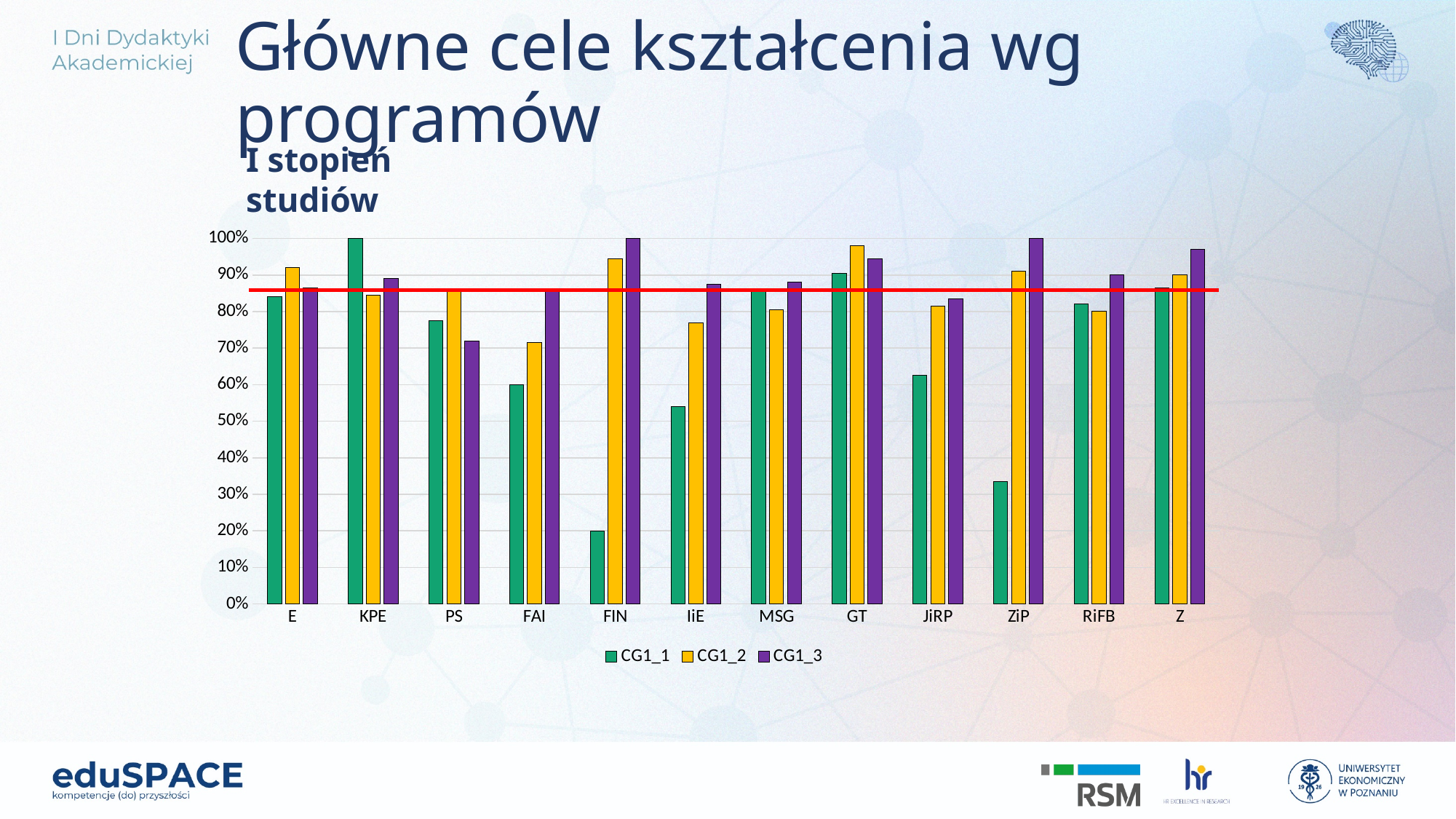
Which category has the lowest CG1_1 value? FIN Is the CG1_1 value for IiE greater or less than 50%? greater What colour are the CG1_3 bars? purple Which category has the highest CG1_2 value? GT What kind of chart is shown on the slide? bar chart How many categories are shown on the x axis? 12 How many series does the legend list? 3 What is the CG1_1 value for FIN? 20% For E, which is larger: CG1_1 or CG1_2? CG1_2 What is the CG1_1 value for KPE? 100% Is the CG1_2 value for GT greater or less than 90%? greater What is the CG1_3 value for ZiP? 100%